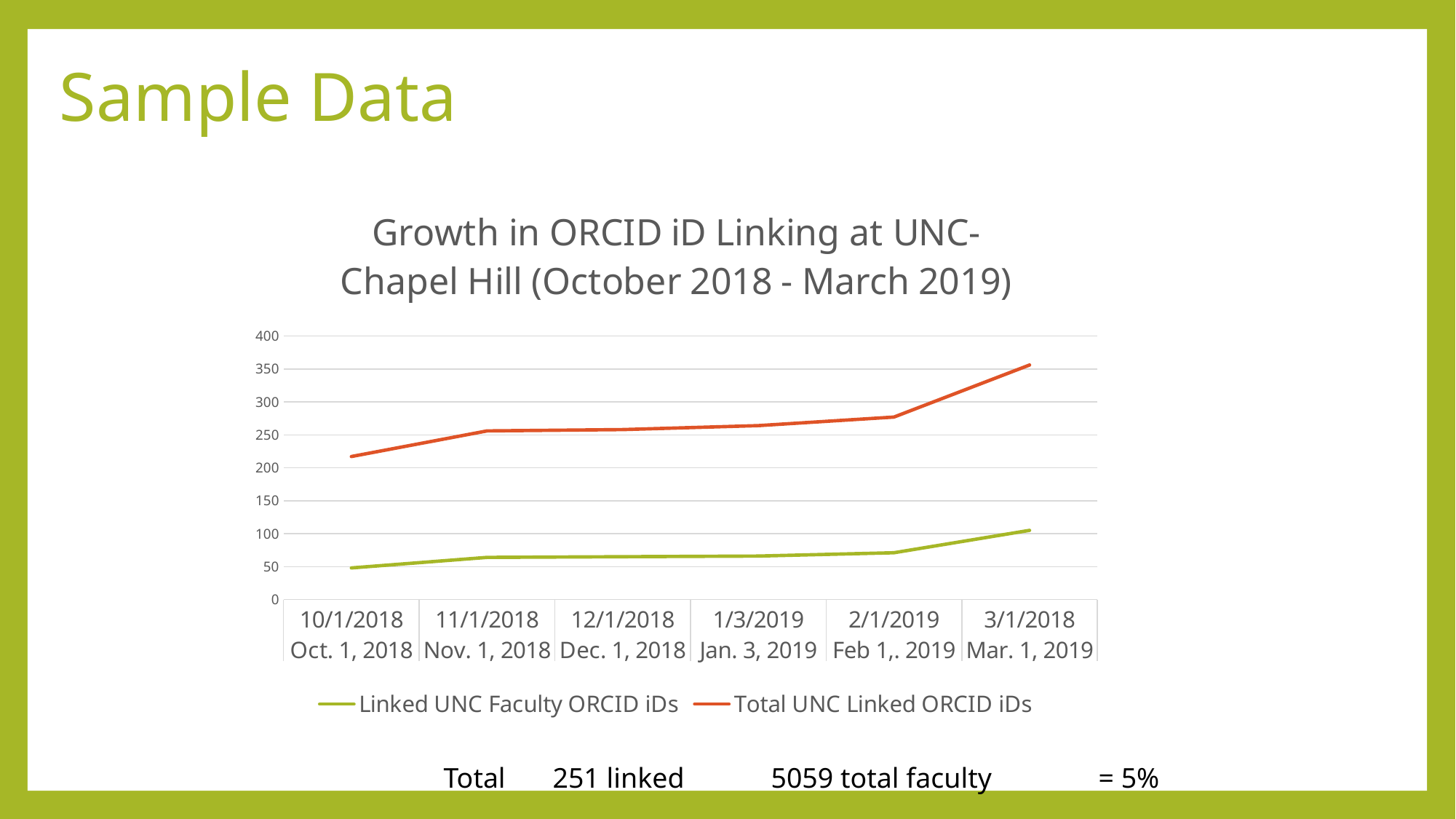
How many series does the legend list? 2 Is the value for Total UNC Linked ORCID iDs at 3/1/2018 greater or less than 300? greater Is the value for Total UNC Linked ORCID iDs at 10/1/2018 greater or less than 250? less What kind of chart is shown on the slide? line chart How many dates are plotted along the x axis? 6 At 2/1/2019, which series has the larger value, Linked UNC Faculty ORCID iDs or Total UNC Linked ORCID iDs? Total UNC Linked ORCID iDs Is the value for Linked UNC Faculty ORCID iDs at 10/1/2018 greater or less than 100? less Which series is shown in orange in the legend? Total UNC Linked ORCID iDs At which date is the value for Total UNC Linked ORCID iDs highest? 3/1/2018 What is the title of the chart? Growth in ORCID iD Linking at UNC-Chapel Hill (October 2018 - March 2019) At which date is the value for Linked UNC Faculty ORCID iDs lowest? 10/1/2018 Do the values for Total UNC Linked ORCID iDs rise or fall from 10/1/2018 to 3/1/2018? rise